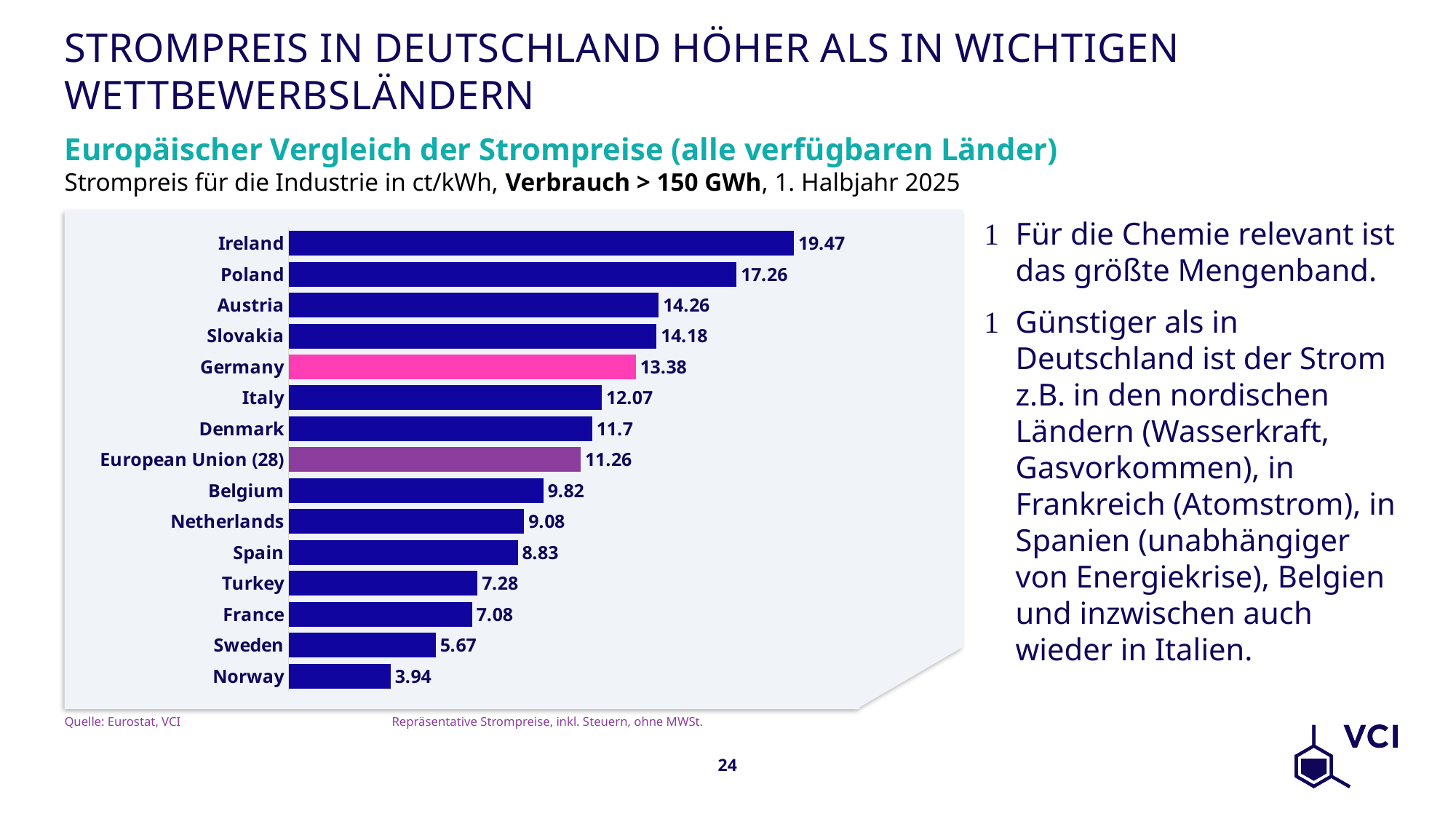
What is the difference between the values for Ireland and Germany? 6.09 What is the difference between the values for Germany and France? 6.3 What is the value shown for Norway? 3.94 What type of chart is shown on the slide? Bar chart Which has a higher value, Poland or Austria? Poland Which bar in the chart is highlighted in pink? Germany What is the electricity price shown for Germany? 13.38 Which country has the lowest electricity price in the chart? Norway Which country has the highest electricity price in the chart? Ireland What is the value shown for European Union (28)? 11.26 Which has a higher value, Sweden or Turkey? Turkey How many countries or regions are shown in the chart? 15